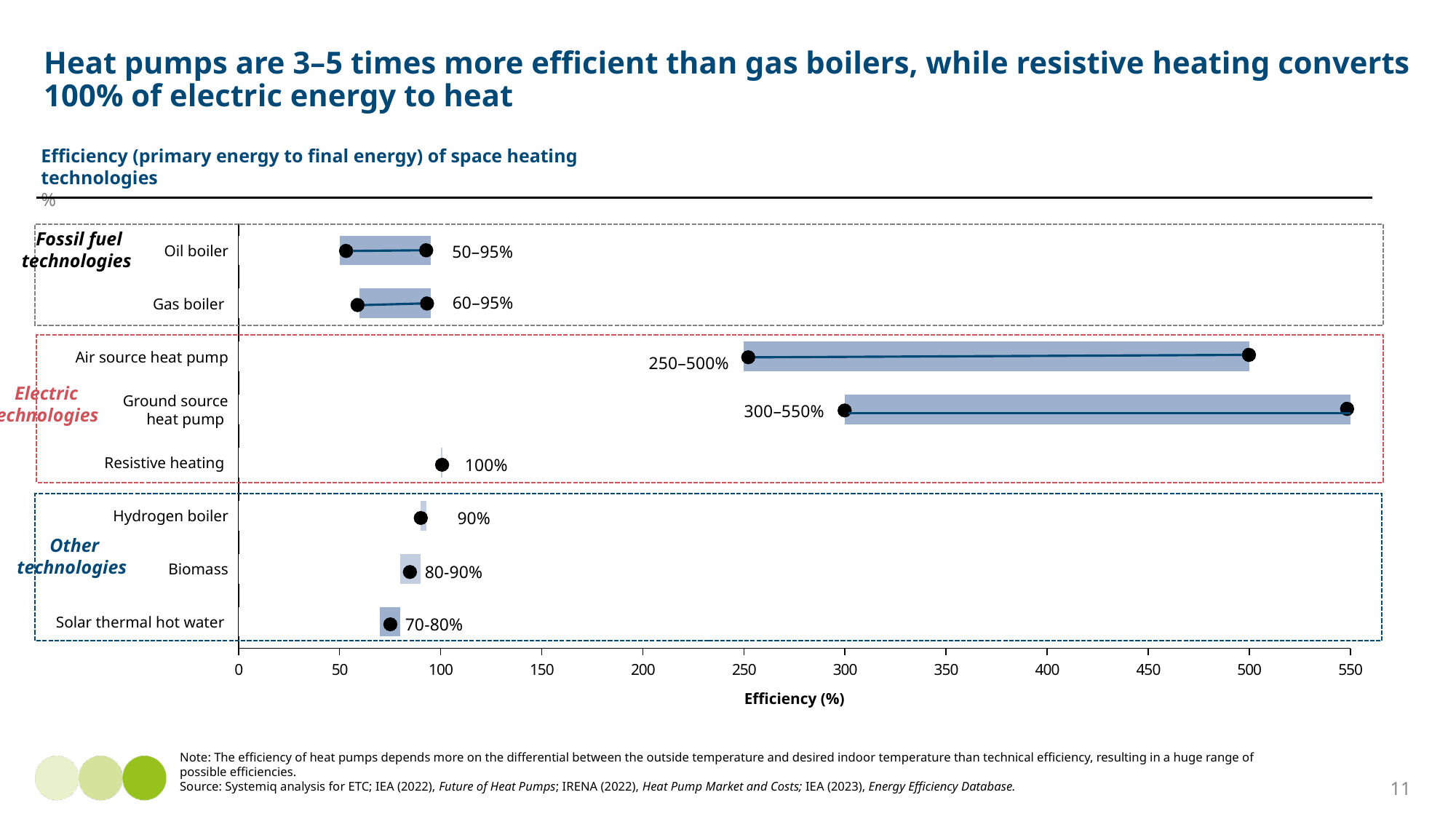
By how many percentage points does the upper bound of the Ground source heat pump exceed the upper bound of the Air source heat pump? 50 How many technology groups are the categories divided into on the chart? 3 What is the title of the horizontal axis? Efficiency (%) How many space heating technologies are plotted on the chart? 8 What efficiency range is shown for the Oil boiler? 50–95% Which technology has the highest upper efficiency value on the chart? Ground source heat pump Which technology has the lowest lower-bound efficiency value on the chart? Oil boiler What efficiency range is shown for Solar thermal hot water? 70-80% What efficiency value is shown for Resistive heating? 100% Which has the higher efficiency value, the Hydrogen boiler or Resistive heating? Resistive heating What efficiency range is shown for the Air source heat pump? 250–500% What efficiency range is shown for the Ground source heat pump? 300–550%